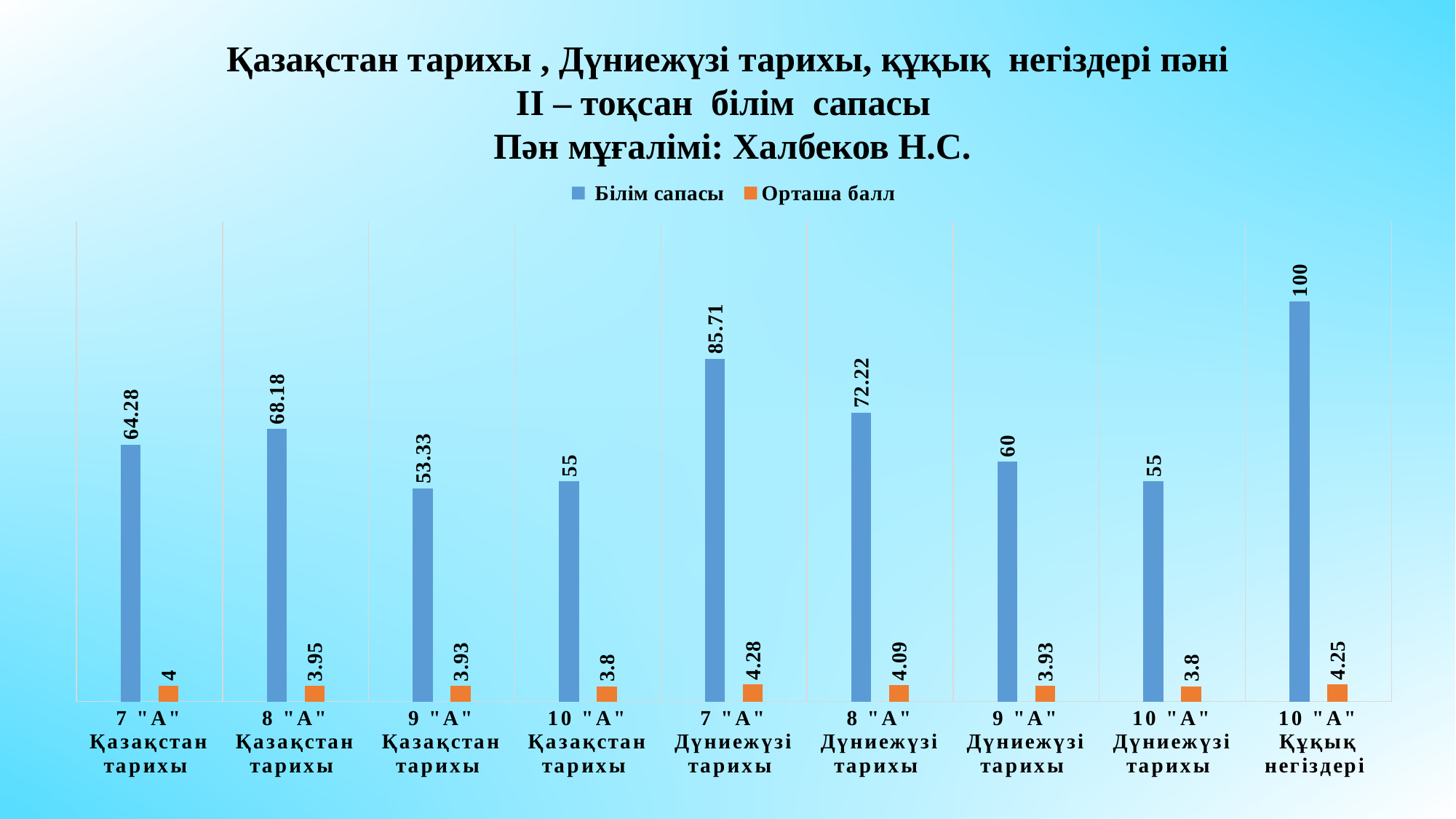
Which category has the lowest Білім сапасы value? 9 "А" Қазақстан тарихы How many categories are shown on the x axis? 9 What is the Орташа балл value for 8 "А" Қазақстан тарихы? 3.95 How many series does the legend list? 2 What is the Орташа балл value for 10 "А" Құқық негіздері? 4.25 What is the Білім сапасы value for 7 "А" Дүниежүзі тарихы? 85.71 Which category has the highest Білім сапасы value? 10 "А" Құқық негіздері What kind of chart is shown on the slide? Bar chart Which category has the highest Орташа балл value? 7 "А" Дүниежүзі тарихы What is the difference between the Білім сапасы values for 8 "А" Дүниежүзі тарихы and 8 "А" Қазақстан тарихы? 4.04 Which is larger, the Білім сапасы value for 7 "А" Қазақстан тарихы or for 9 "А" Дүниежүзі тарихы? 7 "А" Қазақстан тарихы What is the Білім сапасы value for 9 "А" Қазақстан тарихы? 53.33